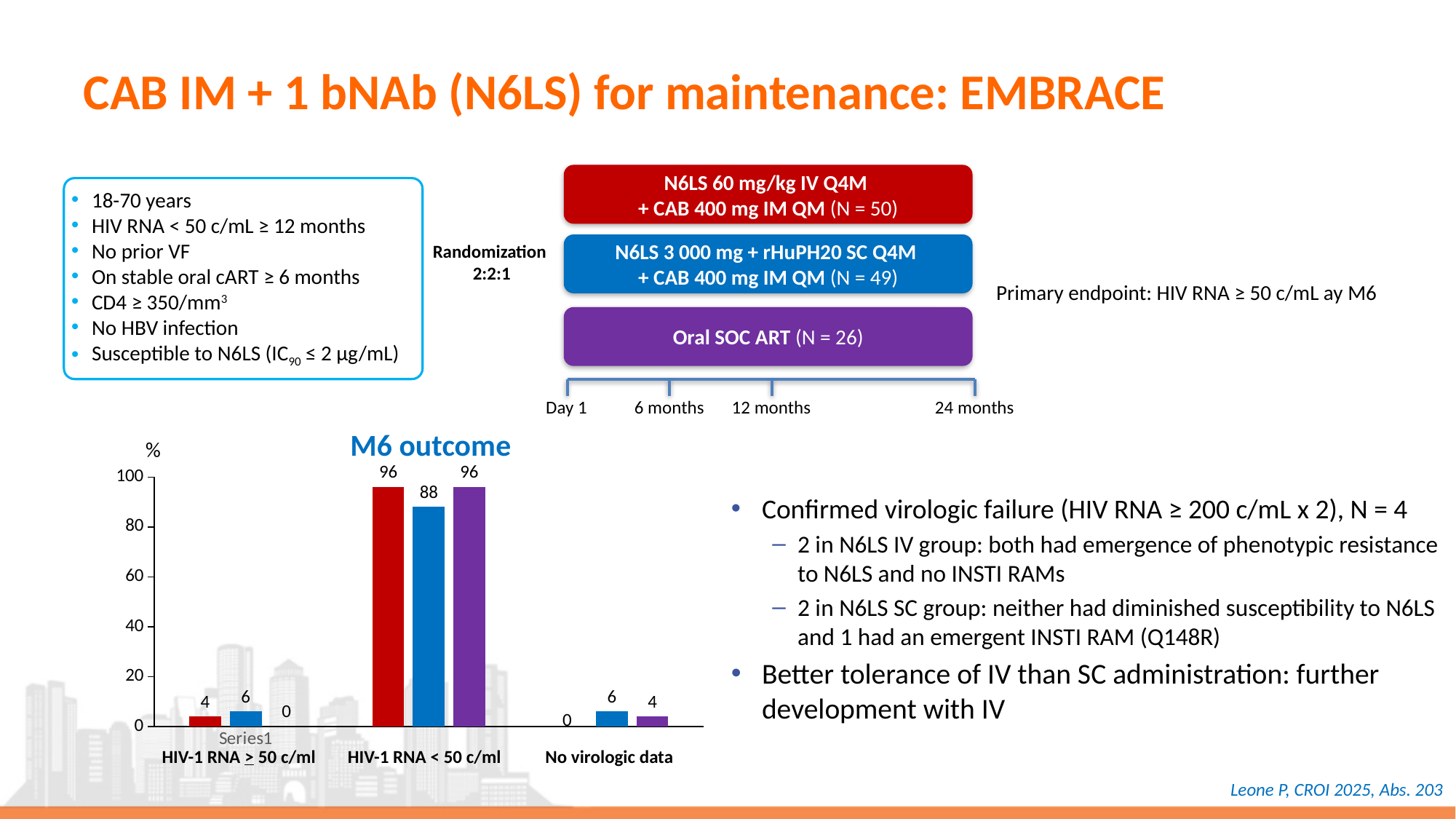
In the M6 outcome chart, what is the difference between the red bar and the blue bar for HIV-1 RNA < 50 c/ml? 8 In the M6 outcome chart, what is the value of the red bar for HIV-1 RNA < 50 c/ml? 96 In the M6 outcome chart, what is the value of the blue bar for No virologic data? 6 In the M6 outcome chart, which is larger for No virologic data: the blue bar or the purple bar? the blue bar In the M6 outcome chart, what is the value of the purple bar for HIV-1 RNA ≥ 50 c/ml? 0 What type of chart is the M6 outcome chart? bar chart In the M6 outcome chart, what is the value of the blue bar for HIV-1 RNA < 50 c/ml? 88 In the M6 outcome chart, what is the value of the red bar for HIV-1 RNA ≥ 50 c/ml? 4 In the M6 outcome chart, which category has the highest values across all bars? HIV-1 RNA < 50 c/ml How many categories are shown on the x axis of the M6 outcome chart? 3 What is the title of the bar chart on the slide? M6 outcome In the M6 outcome chart, is the value of the blue bar for HIV-1 RNA < 50 c/ml greater or less than 80? greater